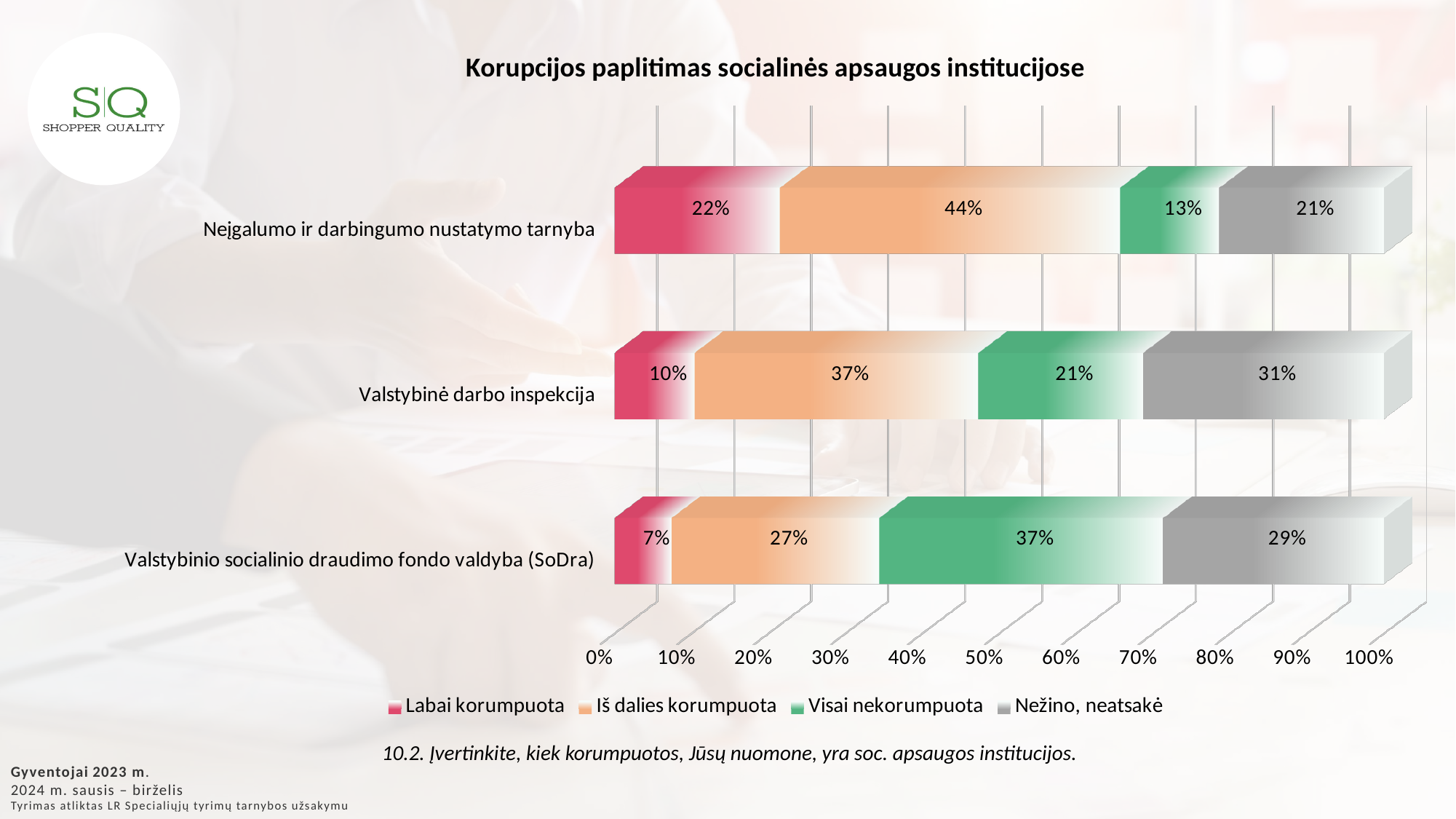
Which institution has the lowest 'Visai nekorumpuota' share? Neįgalumo ir darbingumo nustatymo tarnyba How many series does the legend list? 4 What is the title of the chart? Korupcijos paplitimas socialinės apsaugos institucijose What kind of chart is shown on the slide? Stacked bar chart Which is larger: the 'Nežino, neatsakė' share for SoDra or for Neįgalumo ir darbingumo nustatymo tarnyba? SoDra What is the difference between the 'Iš dalies korumpuota' values for Neįgalumo ir darbingumo nustatymo tarnyba and SoDra? 17 percentage points What is the 'Nežino, neatsakė' value for Valstybinė darbo inspekcija? 31% Which institution has the highest 'Labai korumpuota' share? Neįgalumo ir darbingumo nustatymo tarnyba What is the 'Iš dalies korumpuota' value for Valstybinė darbo inspekcija? 37% What percentage of respondents rated Neįgalumo ir darbingumo nustatymo tarnyba as 'Labai korumpuota'? 22% What is the 'Visai nekorumpuota' value for Valstybinio socialinio draudimo fondo valdyba (SoDra)? 37% How many institutions are shown on the chart? 3